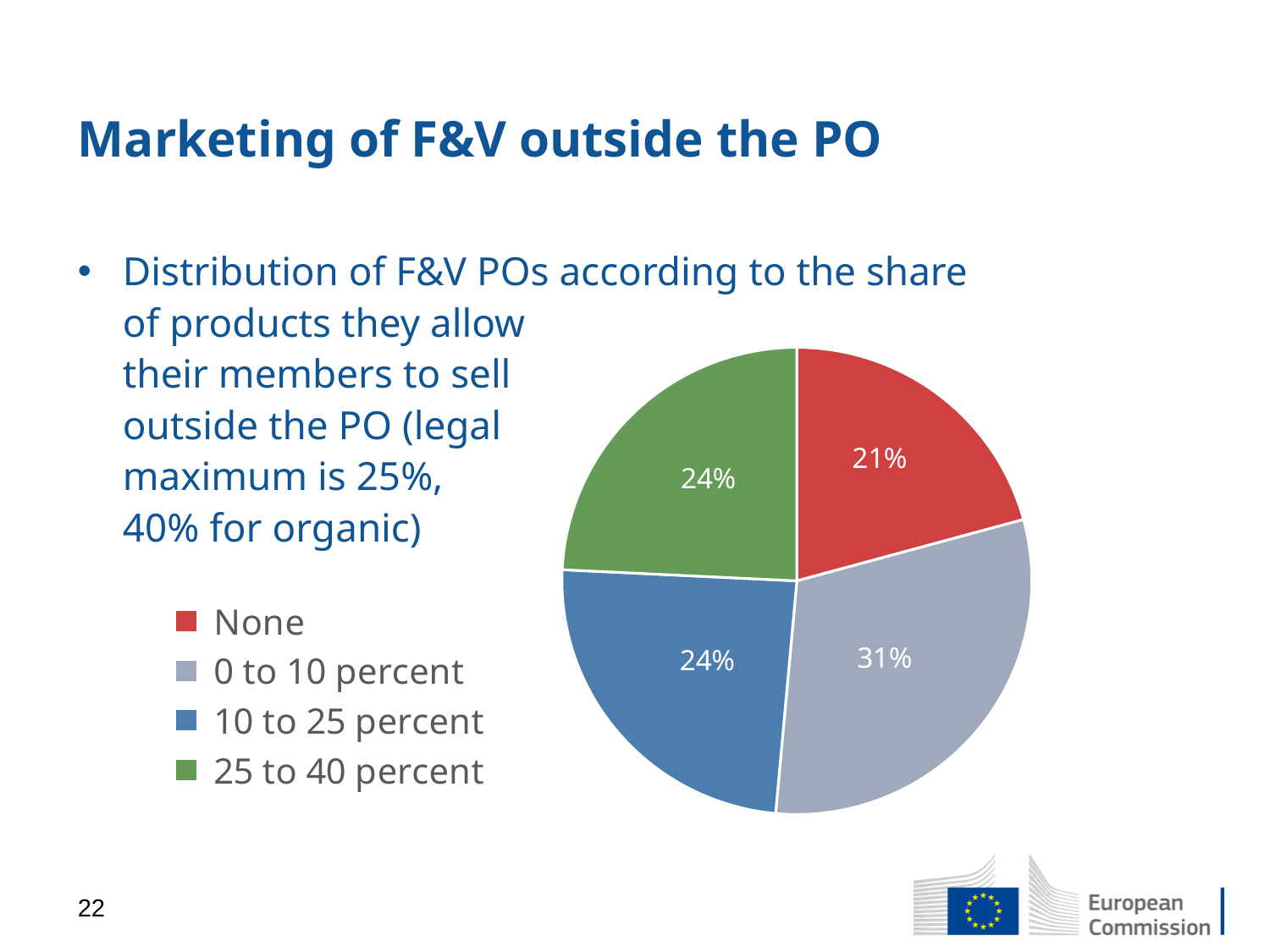
What share of the pie does the '0 to 10 percent' slice represent? 31% Which legend entry is shown in green? 25 to 40 percent What share of the pie does the '10 to 25 percent' slice represent? 24% Which category has the largest slice of the pie? 0 to 10 percent How many slices does the pie chart have? 4 What colour is the 'None' slice in the pie chart? red Which is larger, the 'None' slice or the '10 to 25 percent' slice? 10 to 25 percent Which category has the smallest slice of the pie? None What is the difference in percentage points between the '0 to 10 percent' slice and the 'None' slice? 10 What share of the pie does the 'None' slice represent? 21% What kind of chart is shown on the slide? pie chart